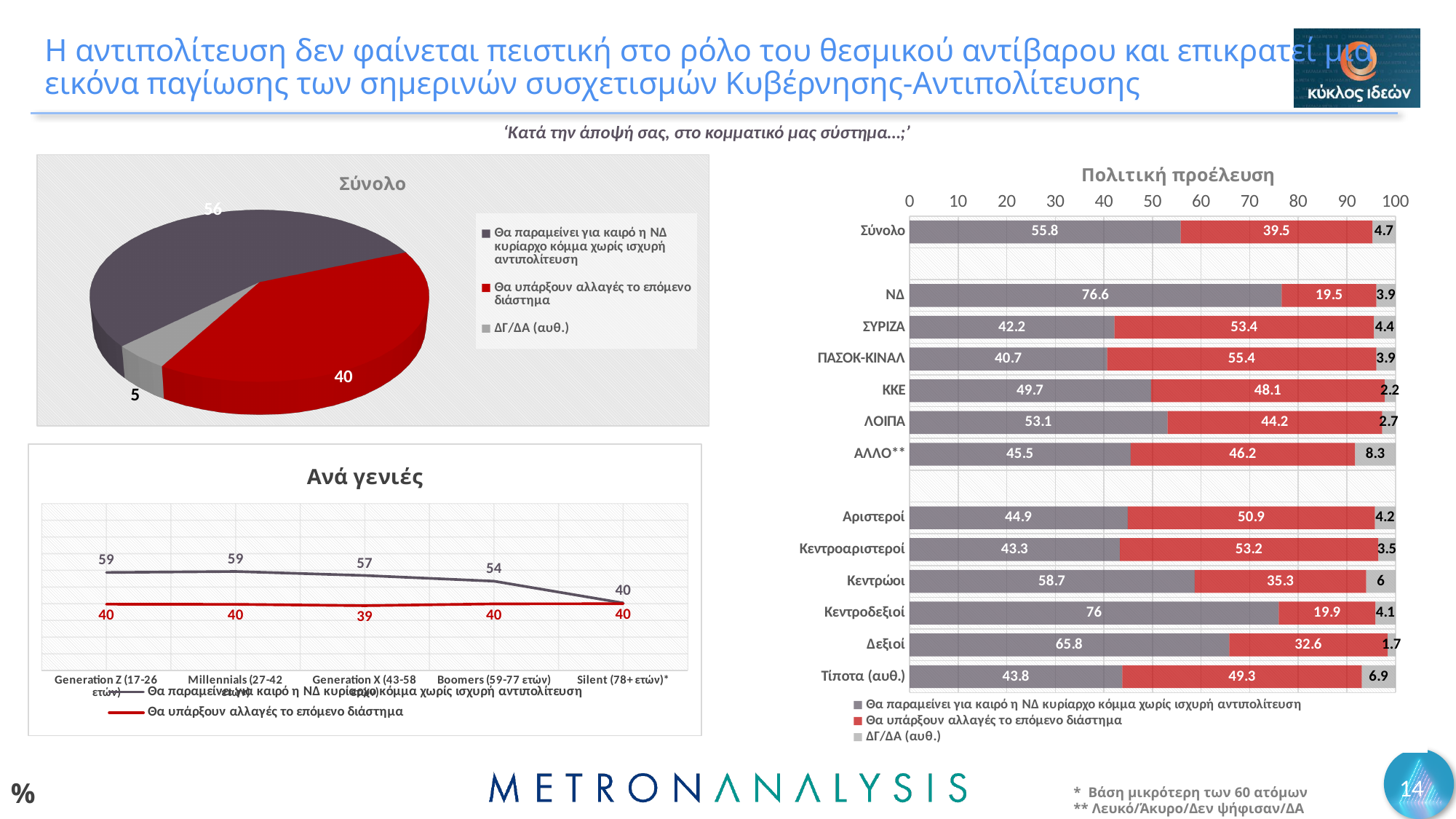
In the 'Πολιτική προέλευση' chart, what is the value of the red series ('Θα υπάρξουν αλλαγές το επόμενο διάστημα') for ΠΑΣΟΚ-ΚΙΝΑΛ? 55.4 In the 'Πολιτική προέλευση' chart, which category has the highest value for the grey series ('Θα παραμείνει για καιρό η ΝΔ κυρίαρχο κόμμα χωρίς ισχυρή αντιπολίτευση')? ΝΔ In the 'Ανά γενιές' line chart, does the dark line ('Θα παραμείνει για καιρό η ΝΔ κυρίαρχο κόμμα...') rise or fall from Generation Z to Silent? fall In the 'Πολιτική προέλευση' chart, what is the difference between the grey series values for ΝΔ and ΣΥΡΙΖΑ? 34.4 How many categories are shown in the 'Πολιτική προέλευση' chart? 13 In the 'Πολιτική προέλευση' chart, which category has the lowest ΔΓ/ΔΑ value? Δεξιοί How many series does the legend of the 'Πολιτική προέλευση' chart list? 3 In the 'Ανά γενιές' line chart, what is the value of the dark line for Boomers (59-77 ετών)? 54 In the 'Πολιτική προέλευση' chart, what is the value of the first (grey) series for ΝΔ? 76.6 In the 'Σύνολο' pie chart, what is the value of the ΔΓ/ΔΑ (αυθ.) slice? 5 What type of chart is the 'Σύνολο' chart on the left? pie chart In the 'Πολιτική προέλευση' chart, which is larger for ΚΚΕ: the grey series value or the red series value? the grey series (49.7)